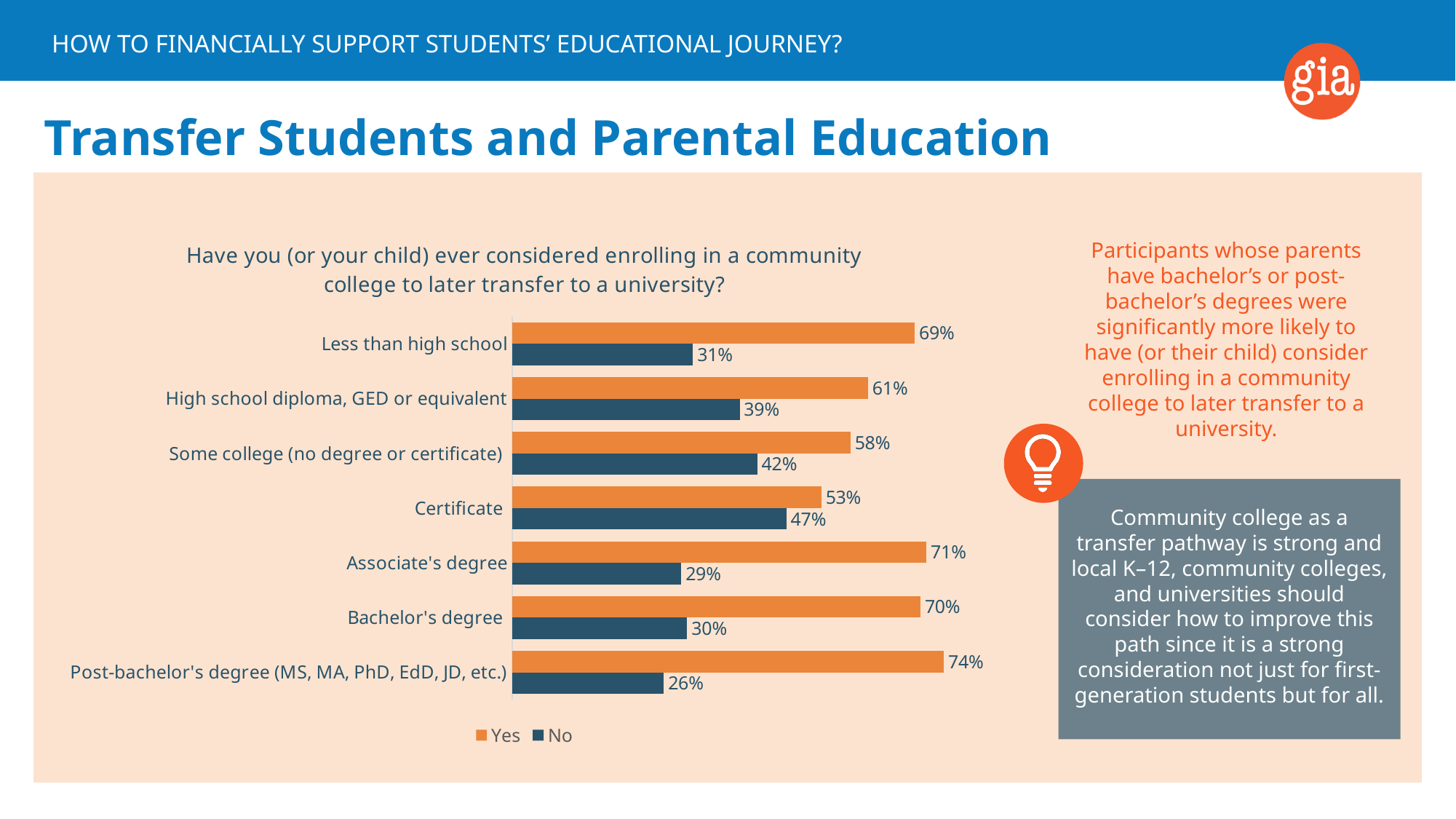
What is the Yes value for the Post-bachelor's degree category? 74% What is the No value for the Some college (no degree or certificate) category? 42% How many series does the legend list? 2 What is the No value for the Certificate category? 47% What kind of chart is shown on the slide? Bar chart How many parental education categories are shown in the chart? 7 What percentage of participants whose parents have less than a high school education answered Yes? 69% Which is larger: the Yes value for Bachelor's degree or the Yes value for High school diploma, GED or equivalent? Bachelor's degree What is the difference between the Yes and No values for the Associate's degree category? 42% Which parental education category has the highest Yes value? Post-bachelor's degree (MS, MA, PhD, EdD, JD, etc.) Which parental education category has the lowest Yes value? Certificate Which colour represents the Yes series in the chart? Orange